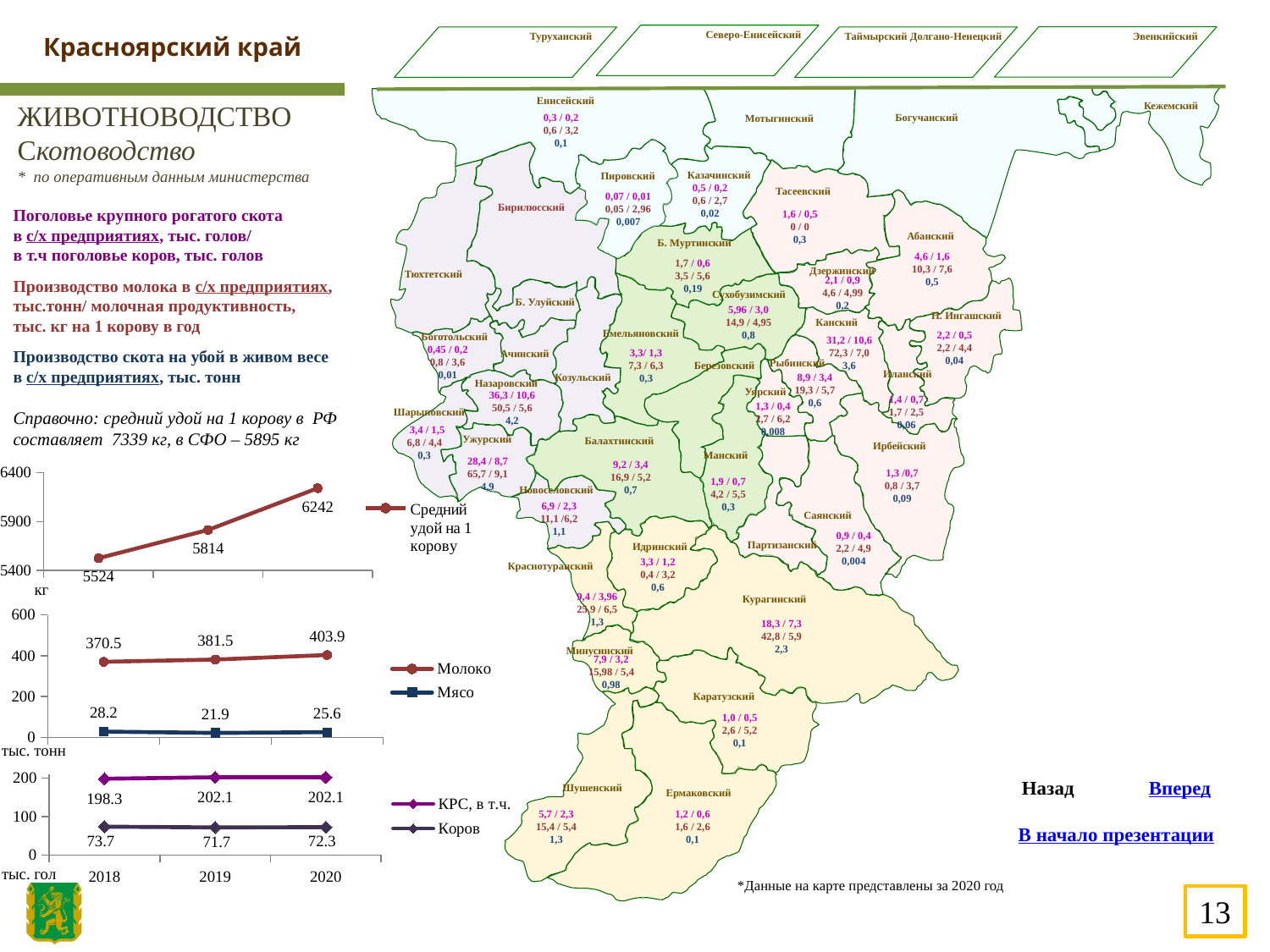
In the middle chart on the left, which year has the lowest value for Мясо? 2019 What type of chart is the bottom chart on the left? line chart In the bottom chart on the left, what is the value of Коров for 2018? 73.7 In the top chart on the left (Средний удой на 1 корову), what is the value for 2018? 5524 In the top chart on the left (Средний удой на 1 корову), what is the value for 2020? 6242 In the top chart on the left (Средний удой на 1 корову), by how much did the value increase from 2018 to 2020? 718 In the middle chart on the left, what is the value of Молоко for 2019? 381.5 How many series does the legend of the middle chart on the left list? 2 In the middle chart on the left, what is the value of Мясо for 2019? 21.9 In the bottom chart on the left, which is larger in 2020: КРС, в т.ч. or Коров? КРС, в т.ч. In the middle chart on the left, what is the difference between Молоко and Мясо in 2020? 378.3 In the top chart on the left (Средний удой на 1 корову), do the values rise or fall from 2018 to 2020? rise